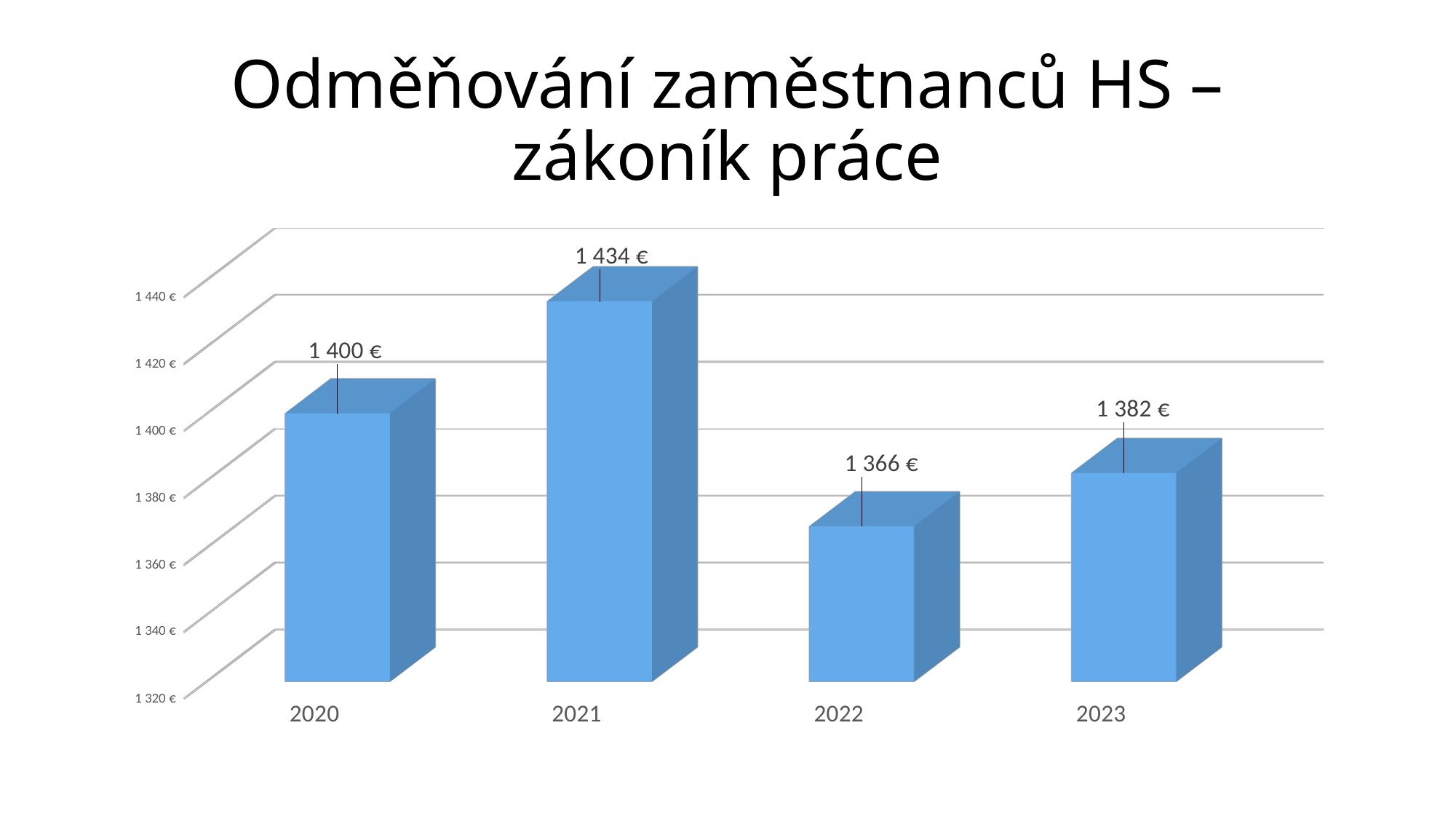
How many years are shown on the chart? 4 What is the difference between the values for 2021 and 2020? 34 € What is the value for 2021? 1 434 € What is the value for 2020? 1 400 € Which is larger, the value for 2020 or the value for 2023? 2020 What is the value for 2022? 1 366 € What kind of chart is shown on the slide? bar chart Which year has the lowest value? 2022 What is the difference between the values for 2023 and 2022? 16 € What is the title of the slide? Odměňování zaměstnanců HS – zákoník práce Which year has the highest value? 2021 What is the value for 2023? 1 382 €